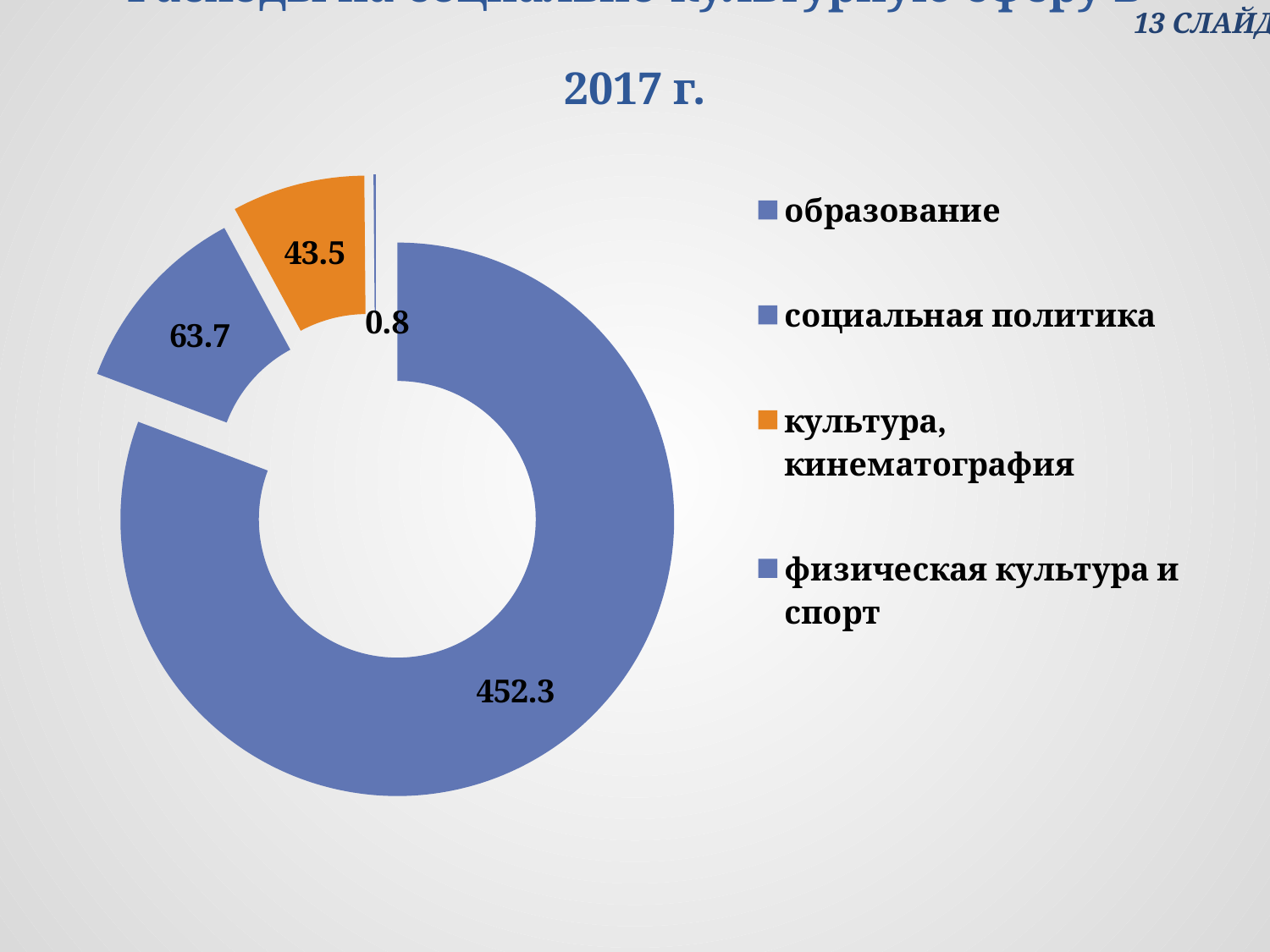
Which is larger, the value for культура, кинематография or the value for социальная политика? социальная политика What is the value for физическая культура и спорт? 0.8 What is the difference between the values for социальная политика and культура, кинематография? 20.2 How many categories does the legend list? 4 What is the difference between the values for образование and социальная политика? 388.6 Which category is shown in orange? культура, кинематография What type of chart is shown on the slide? doughnut (pie) chart Which category has the smallest slice? физическая культура и спорт What is the value for образование? 452.3 What is the value for социальная политика? 63.7 Which category has the largest slice? образование What is the value for культура, кинематография? 43.5